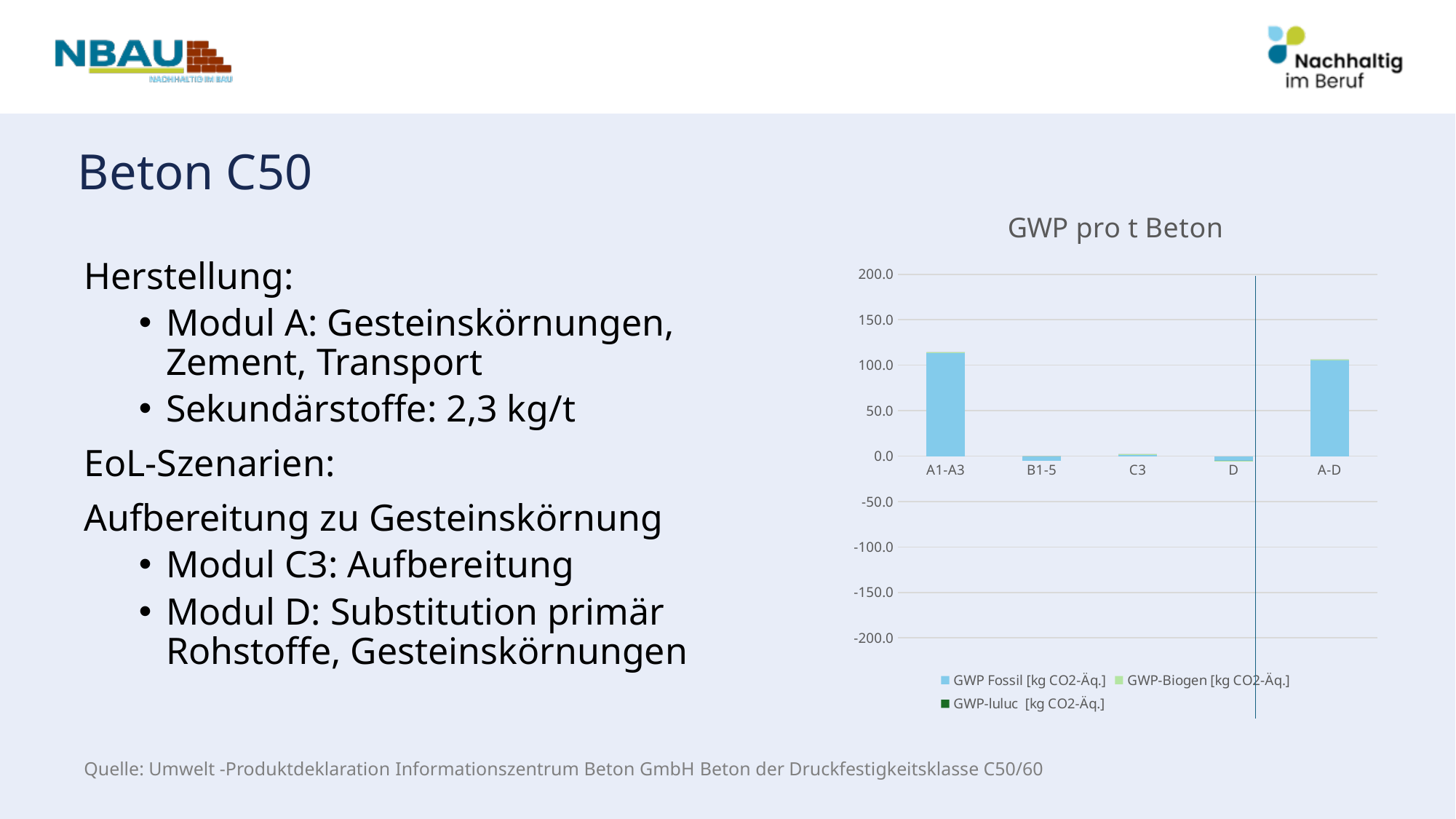
What kind of chart is shown on the slide? bar chart Which of the two is larger, the value for A1-A3 or the value for C3? A1-A3 How many series does the chart legend list? 3 Is the value for A1-A3 greater or less than 150? less Is the value for A-D greater or less than 50? greater Is the value for D greater or less than 0? less What is the title of the chart on the slide? GWP pro t Beton How many categories are shown on the x axis of the chart? 5 Which category has the highest bar in the chart? A1-A3 What unit is given in the legend entries of the chart? kg CO2-Äq.